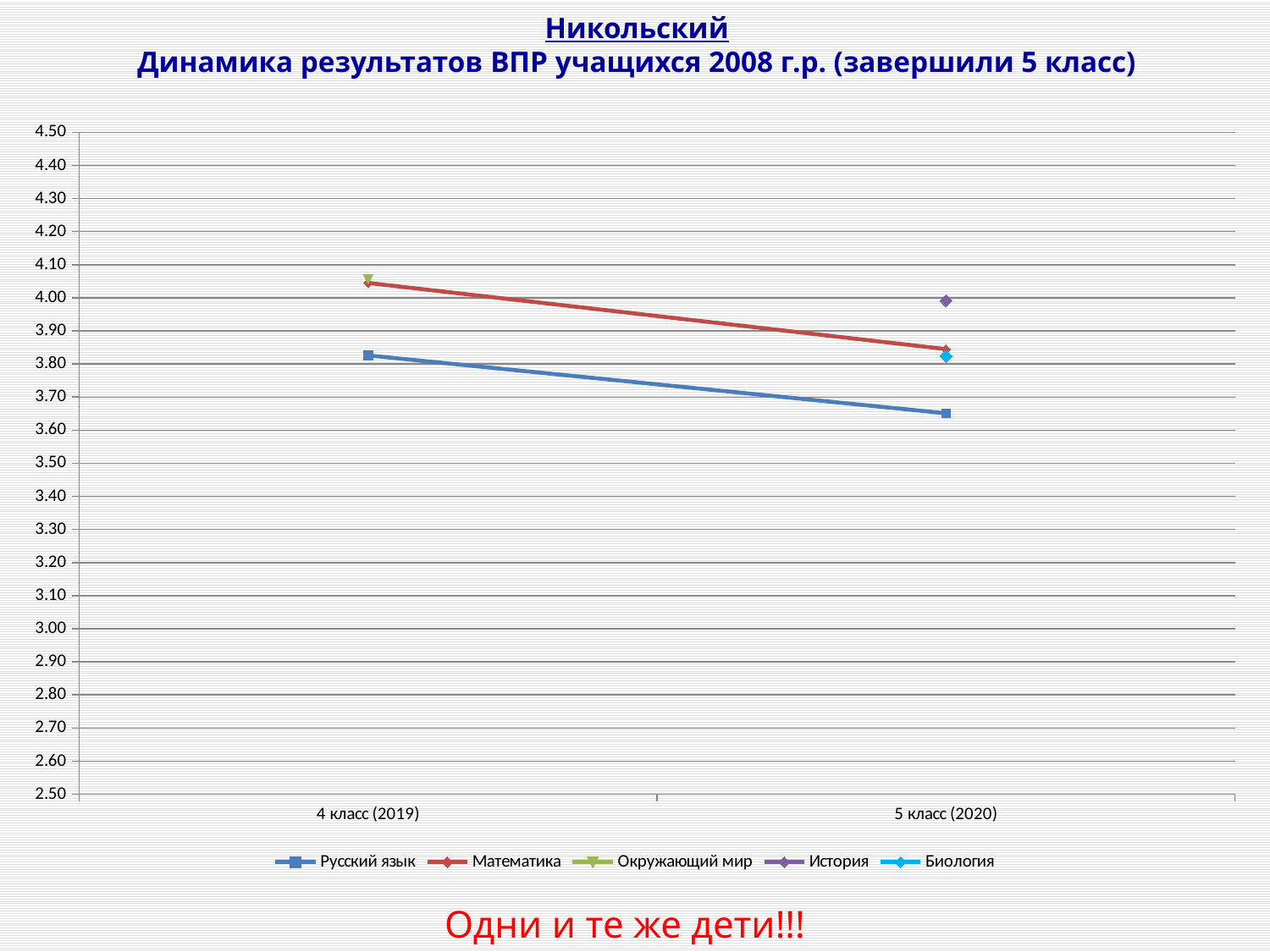
At 4 класс (2019), which is larger: the value for Математика or the value for Русский язык? Математика Does the value for Русский язык rise or fall from 4 класс (2019) to 5 класс (2020)? fall Is the value for Математика at 4 класс (2019) greater or less than 4.00? greater Does the value for Математика rise or fall from 4 класс (2019) to 5 класс (2020)? fall Which series has the highest value at 5 класс (2020)? История Is the value for История at 5 класс (2020) greater or less than 3.90? greater How many categories are shown on the x axis? 2 Which series has the lowest value at 5 класс (2020)? Русский язык What kind of chart is shown on the slide? line chart How many series does the legend list? 5 Is the value for Биология at 5 класс (2020) greater or less than 3.90? less